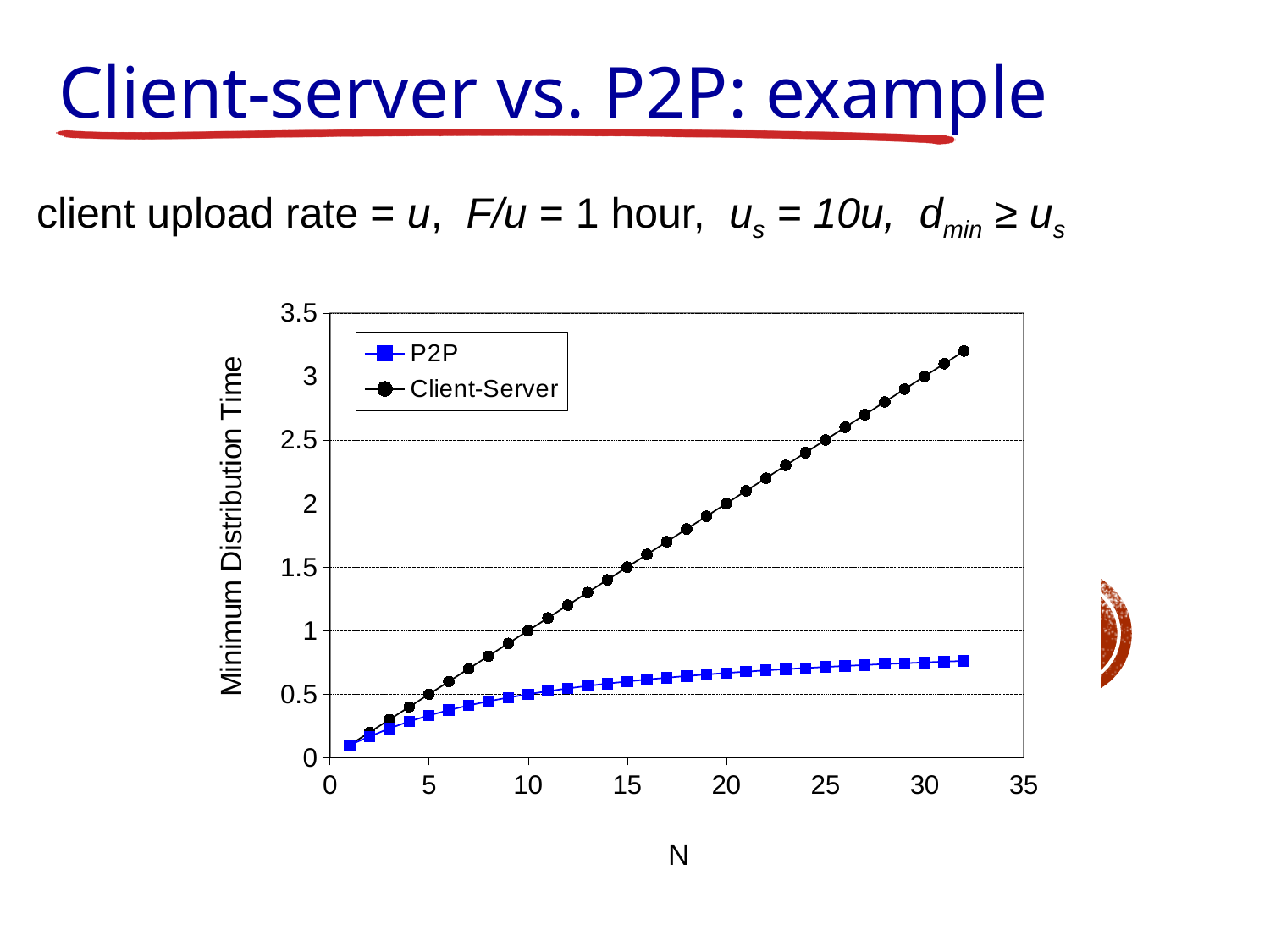
Which series is plotted with blue square markers? P2P Does the Client-Server series rise or fall as N increases? rise What is the label of the y axis? Minimum Distribution Time What kind of chart is shown on the slide? line chart What is the Client-Server value at N = 20? 2 Is the P2P value at N = 30 greater or less than 1? less Is the Client-Server value at N = 25 greater or less than 2? greater What is the Client-Server value at N = 10? 1 How many series does the legend list? 2 At N = 30, which series has the larger value, P2P or Client-Server? Client-Server Is the P2P value at N = 5 greater or less than 0.5? less What is the Client-Server value at N = 30? 3